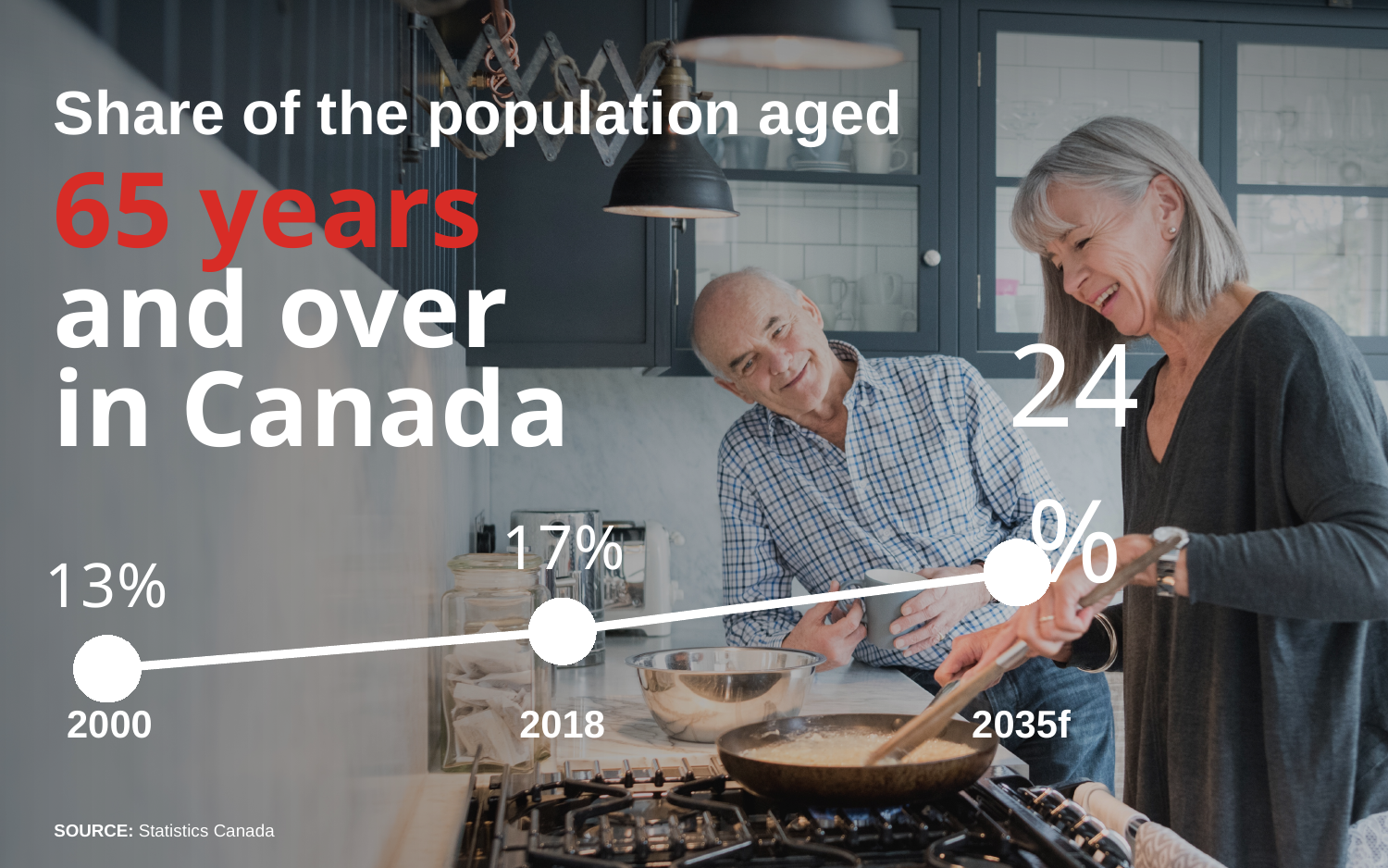
By how many percentage points does the share rise from 2000 to 2018? 4 percentage points What is the source cited for the chart? Statistics Canada What value is shown for 2035f? 24% How many data points are plotted on the chart? 3 What kind of chart is shown on the slide? Line chart Which year has the lowest share of the population aged 65 and over? 2000 Which year has the highest share of the population aged 65 and over? 2035f Do the values rise or fall from 2000 to 2035f? Rise What is the share of the population aged 65 and over in Canada in 2018? 17% What is the share of the population aged 65 and over in Canada in 2000? 13% Which is larger, the share in 2018 or the share in 2035f? 2035f By how many percentage points does the share rise from 2018 to 2035f? 7 percentage points